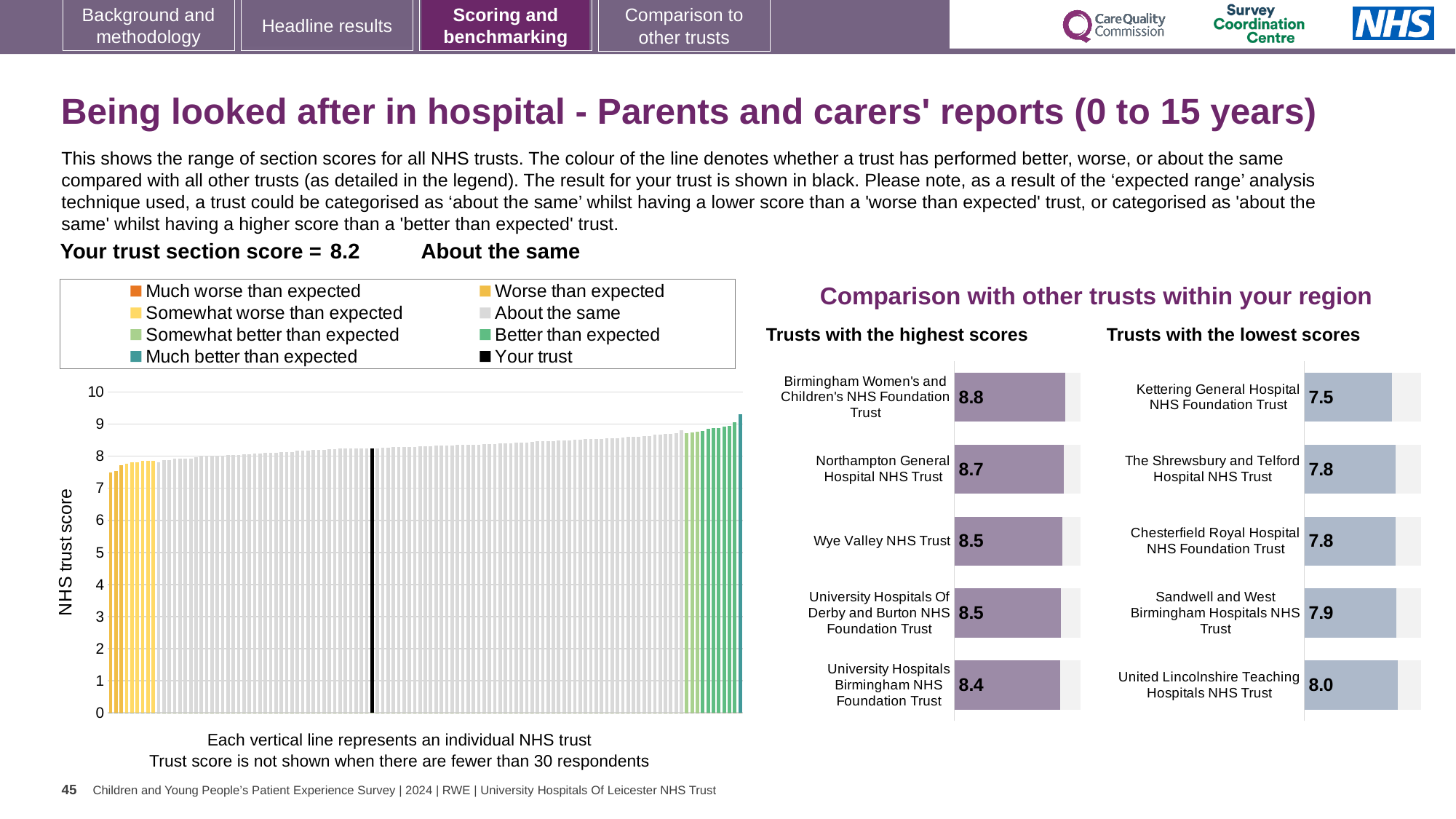
In the 'Trusts with the lowest scores' chart, what is the score for United Lincolnshire Teaching Hospitals NHS Trust? 8.0 What kind of chart is the large chart on the left showing NHS trust scores? bar chart In the 'Trusts with the highest scores' chart, what is the difference between the scores of Birmingham Women's and Children's NHS Foundation Trust and University Hospitals Birmingham NHS Foundation Trust? 0.4 In the large chart on the left, do the NHS trust scores rise or fall from left to right? rise In the 'Trusts with the highest scores' chart, what is the score for Northampton General Hospital NHS Trust? 8.7 How many entries does the legend above the large chart on the left list? 8 In the 'Trusts with the lowest scores' chart, what is the difference between the scores of United Lincolnshire Teaching Hospitals NHS Trust and Kettering General Hospital NHS Foundation Trust? 0.5 In the 'Trusts with the highest scores' chart, which trust has the highest score? Birmingham Women's and Children's NHS Foundation Trust How many trusts are shown in the 'Trusts with the highest scores' chart? 5 In the 'Trusts with the lowest scores' chart, which has the higher score: Sandwell and West Birmingham Hospitals NHS Trust or Kettering General Hospital NHS Foundation Trust? Sandwell and West Birmingham Hospitals NHS Trust What is your trust's section score shown on the slide? 8.2 In the 'Trusts with the lowest scores' chart, which trust has the lowest score? Kettering General Hospital NHS Foundation Trust